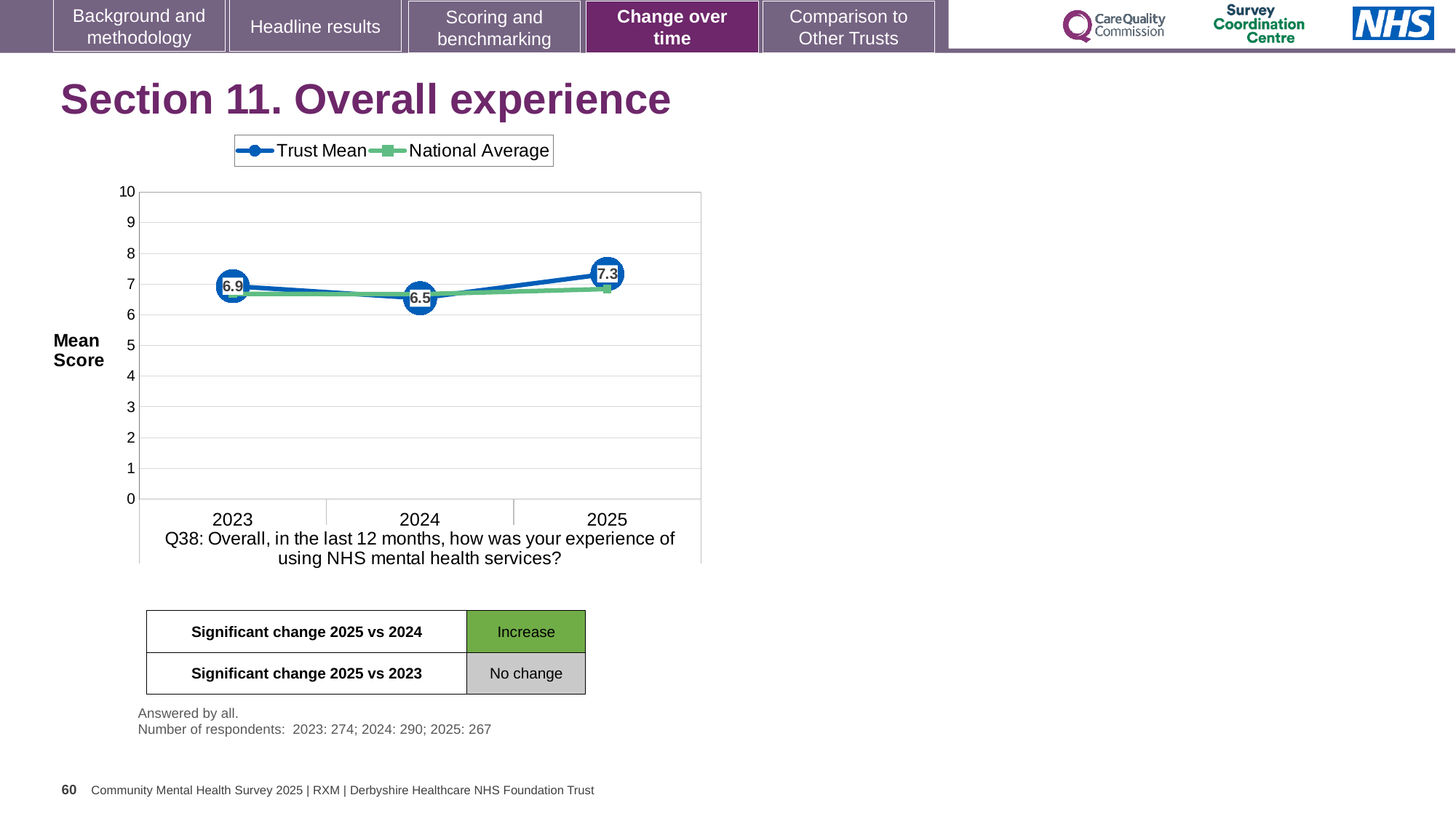
Is the National Average value for 2024 greater or less than 5? greater How many series does the legend list? 2 Which is larger, the Trust Mean in 2023 or in 2025? 2025 What is the Trust Mean score for 2023? 6.9 What is the difference between the Trust Mean in 2025 and in 2024? 0.8 How many years are shown on the x axis? 3 In which year is the Trust Mean highest? 2025 What is the label on the y axis of the chart? Mean Score What is the Trust Mean score for 2025? 7.3 What is the Trust Mean score for 2024? 6.5 What kind of chart is shown on the slide? line chart In which year is the Trust Mean lowest? 2024